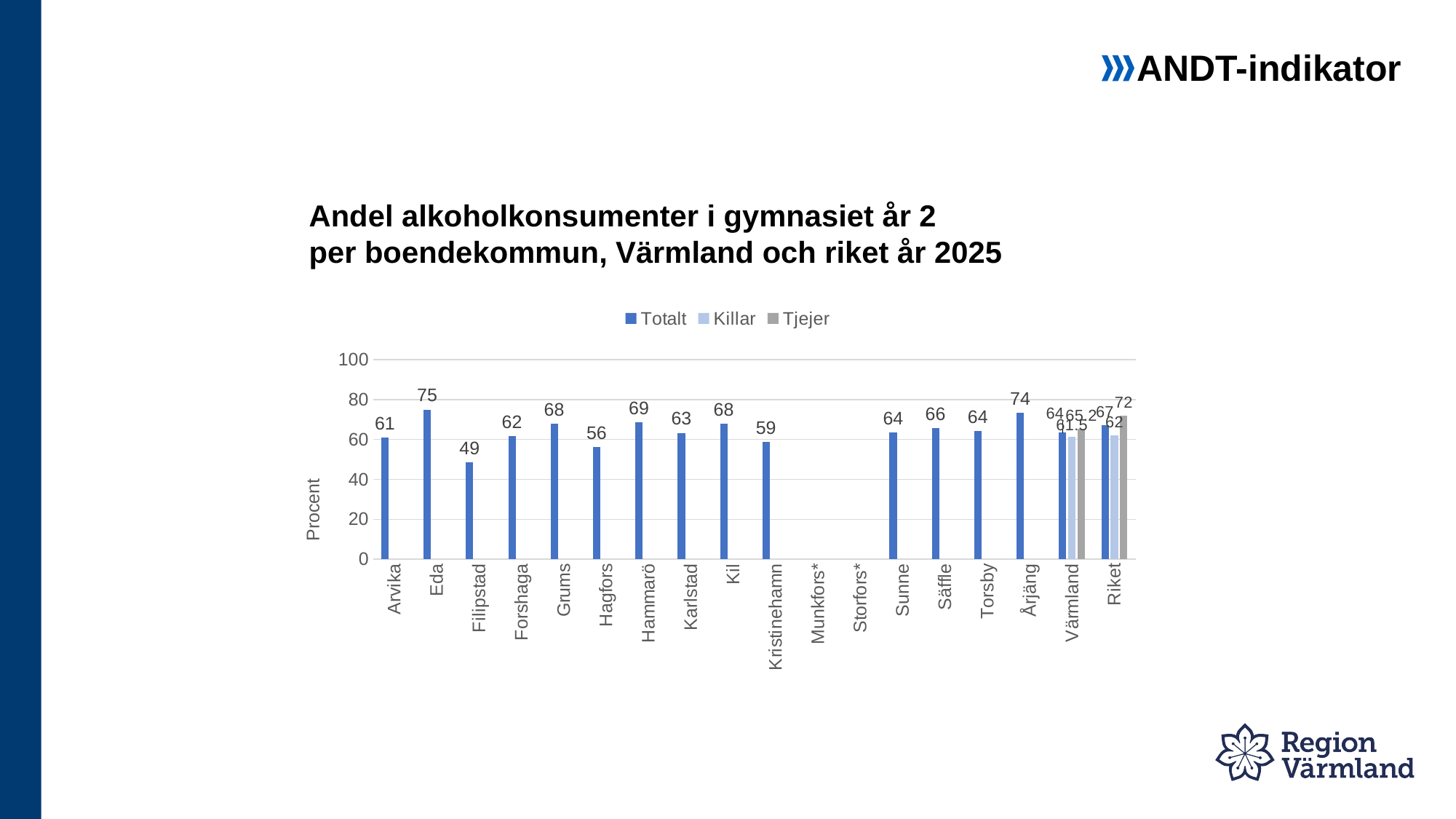
What is the difference between the Totalt values for Eda and Filipstad? 26 What is the Tjejer value for Riket? 72 What is the Killar value for Riket? 62 Which municipality has the highest Totalt value? Eda Which municipality has the lowest Totalt value? Filipstad What is the Totalt value for Eda? 75 What are the three entries in the chart legend? Totalt, Killar, Tjejer What kind of chart is shown on the slide? Bar chart Which has a higher Totalt value, Grums or Hagfors? Grums How many series does the legend list? 3 Is the Totalt value for Hagfors greater or less than 60? less How many categories are listed on the x axis? 18